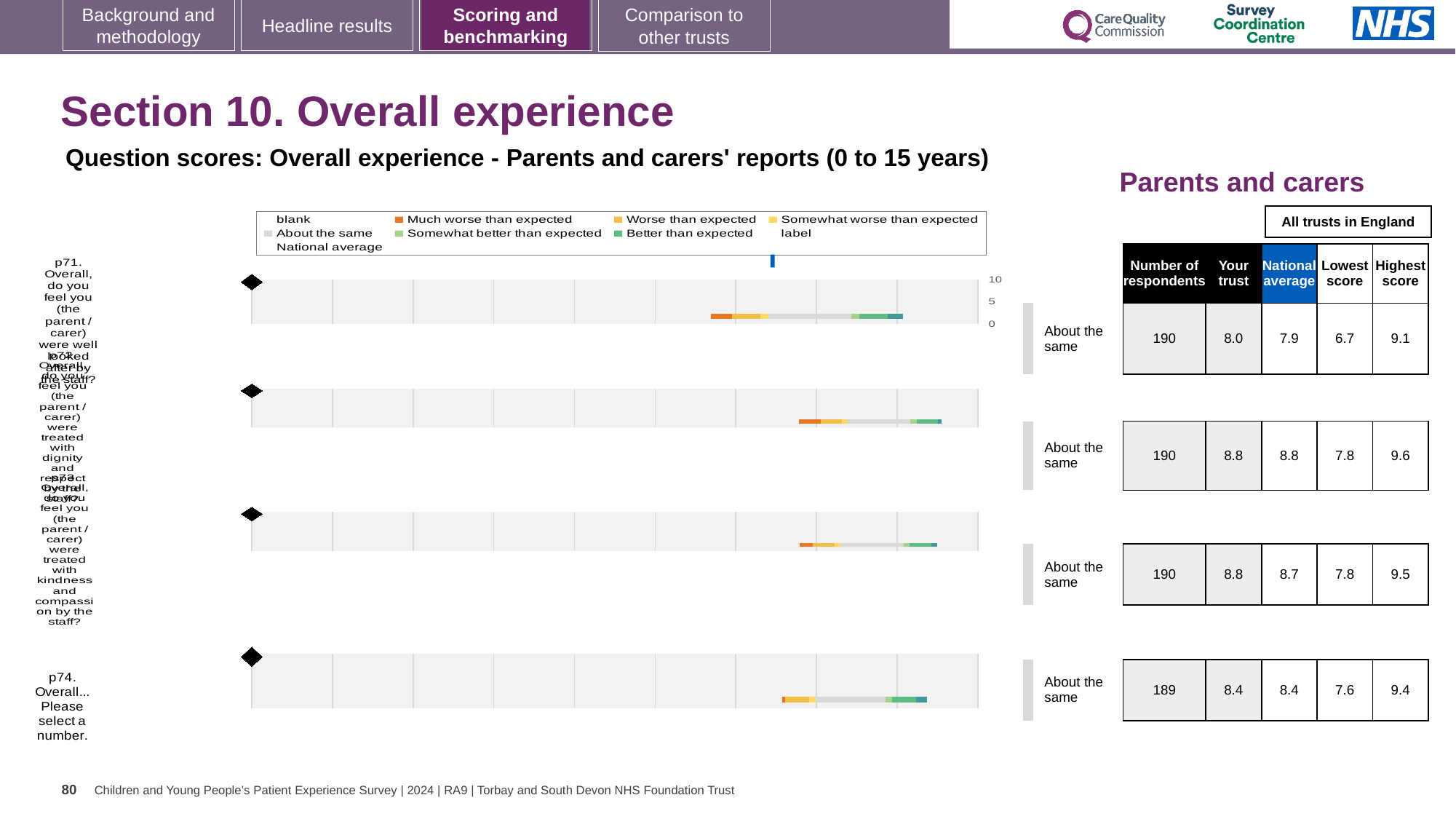
What benchmark label is shown next to the bar for question p74? About the same What is the 'Your trust' score for question p71 in the table beside the chart? 8.0 How many questions (bars) are plotted in the chart? 4 What is the title of the chart on this slide? Question scores: Overall experience - Parents and carers' reports (0 to 15 years) Which row of the table has the highest 'Highest score' value? The second row (9.6) What is the highest score listed for question p74? 9.4 Which question has the lowest 'Lowest score' value in the table? p71 (6.7) How many respondents are listed for question p74? 189 For question p71, which is larger: the 'Your trust' score or the national average? Your trust What kind of chart is used to show the question scores on this slide? Bar chart What is the national average score for question p71? 7.9 What is the difference between the highest score and the lowest score for question p71? 2.4